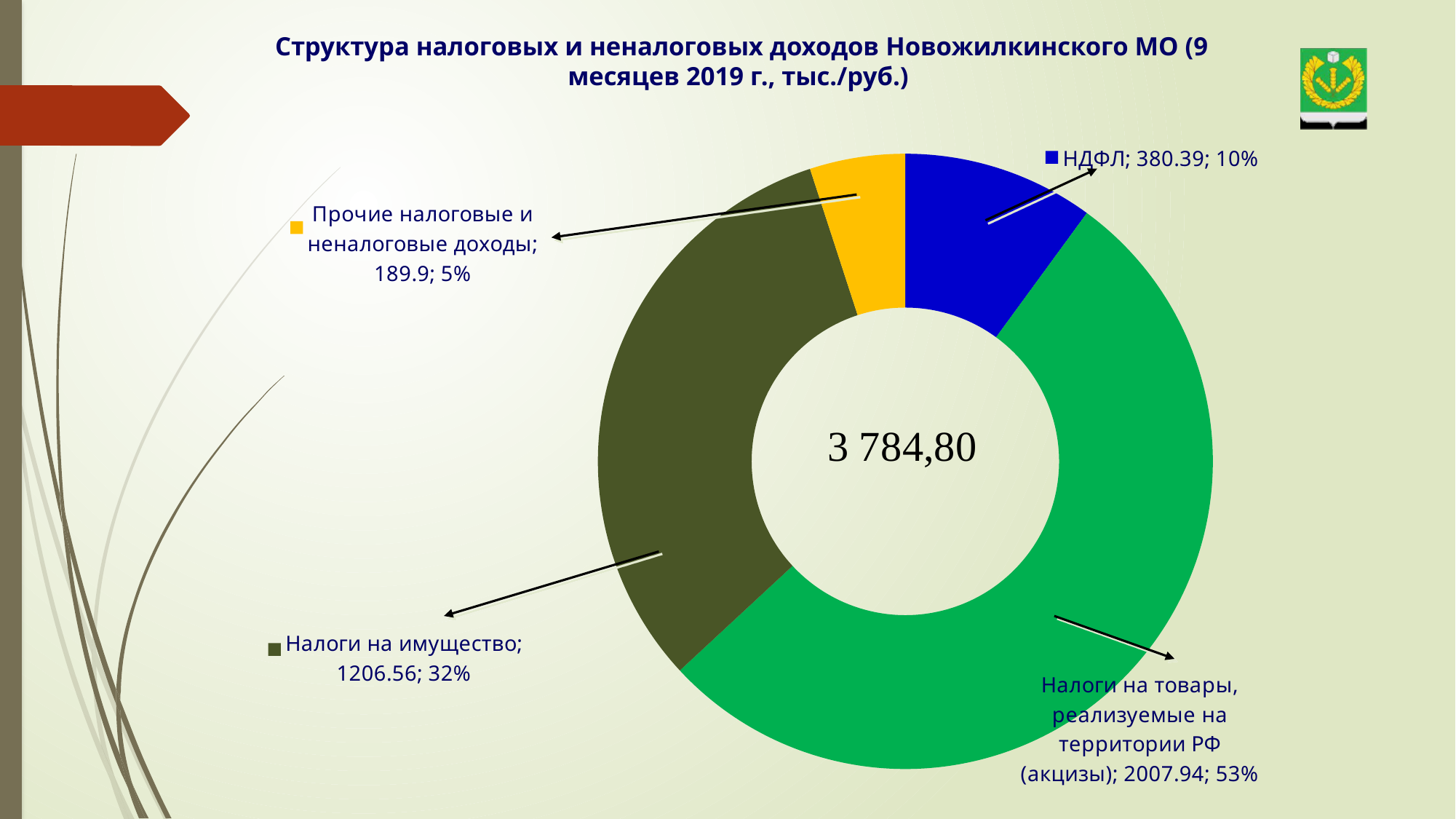
Which category has the smallest share of the chart? Прочие налоговые и неналоговые доходы How many categories does the chart show? 4 What is the value for Налоги на имущество? 1206.56 What is the difference between the values for Налоги на имущество and НДФЛ? 826.17 Which is larger, the value for НДФЛ or the value for Прочие налоговые и неналоговые доходы? НДФЛ What share of the chart does Налоги на имущество represent? 32% What is the value for Налоги на товары, реализуемые на территории РФ (акцизы)? 2007.94 What kind of chart is shown on the slide? Doughnut (pie) chart Which category has the largest share of the chart? Налоги на товары, реализуемые на территории РФ (акцизы) What share of the chart does НДФЛ represent? 10% What is the value for Прочие налоговые и неналоговые доходы? 189.9 What is the value for НДФЛ? 380.39